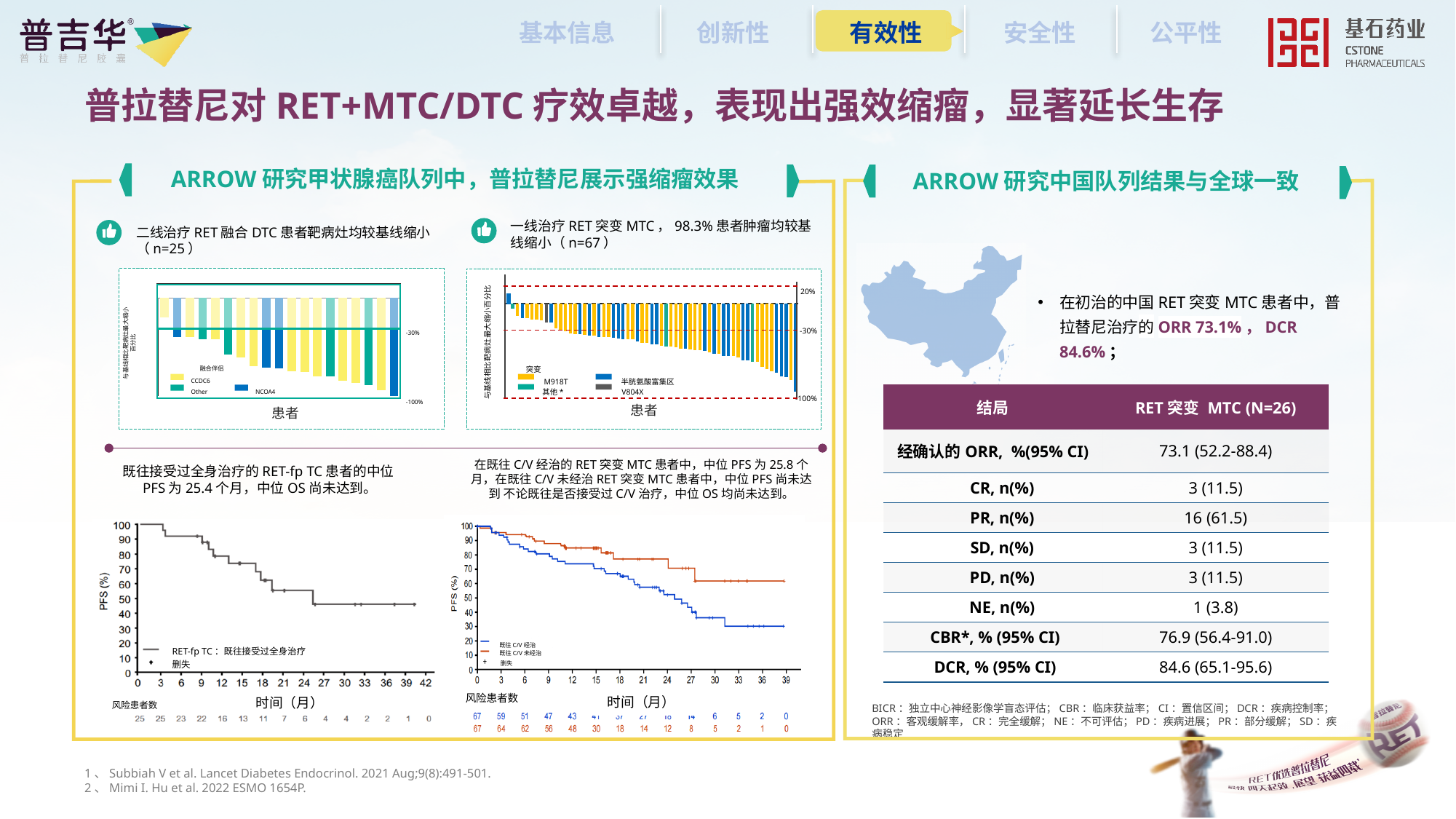
In the bottom-middle PFS chart (RET 突变 MTC), is the PFS of the 既往 C/V 经治 group at 30 months greater or less than 50? less In the bottom-middle PFS chart (RET 突变 MTC), which group has the higher PFS at 36 months, 既往 C/V 经治 or 既往 C/V 未经治? 既往 C/V 未经治 In the top-middle bar chart (一线治疗 RET 突变 MTC), how many entries does the 突变 legend list? 4 In the bottom-left PFS chart (RET-fp TC), how many patients are at risk at 12 months? 16 In the bottom-left PFS chart (RET-fp TC), how many patients are at risk (风险患者数) at 0 months? 25 In the top-left bar chart (RET 融合 DTC), how many entries does the 融合伴侣 legend list? 3 In the bottom-left PFS chart (RET-fp TC), does the PFS curve rise or fall as time increases? fall What kind of chart is the top-left chart (二线治疗 RET 融合 DTC 患者靶病灶均较基线缩小)? bar chart In the bottom-middle PFS chart (RET 突变 MTC), how many patients in the 既往 C/V 未经治 group are at risk at 15 months? 30 In the bottom-middle PFS chart (RET 突变 MTC), how many patients in the 既往 C/V 经治 group are at risk at 3 months? 59 In the bottom-left PFS chart (RET-fp TC), is the PFS value at 36 months greater or less than 60? less In the top-middle bar chart (RET 突变 MTC), what is the topmost percentage tick shown on the y axis? 20%